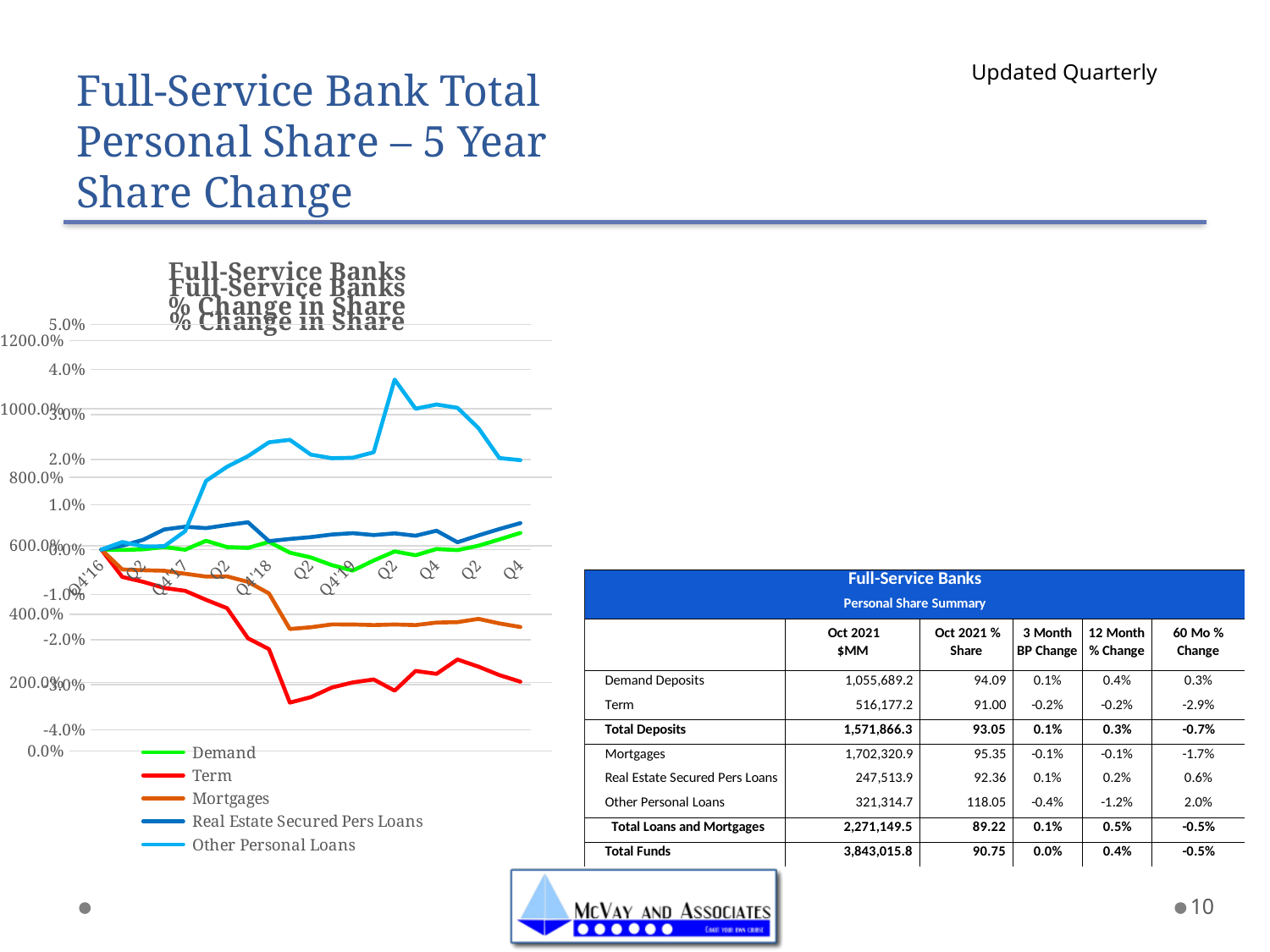
How many series does the legend of the chart list? 5 Is the value for Term at Q4'18 greater or less than -3.0%? greater Is the peak value of the Other Personal Loans line greater or less than 3.0%? greater Does the Term line generally rise or fall from Q4'16 to Q4'18? fall What kind of chart is shown on the slide? line chart Which series in the chart is drawn in red? Term What is the title of the chart? Full-Service Banks % Change in Share Which series has the lowest value at the last point (Q4) on the chart? Term At the last point (Q4), which is larger: the value for Demand or the value for Term? Demand How many labelled points are there along the x axis of the chart? 11 Is the value for Mortgages at the last point (Q4) greater or less than -1.0%? less Which series has the highest value at the last point (Q4) on the chart? Other Personal Loans